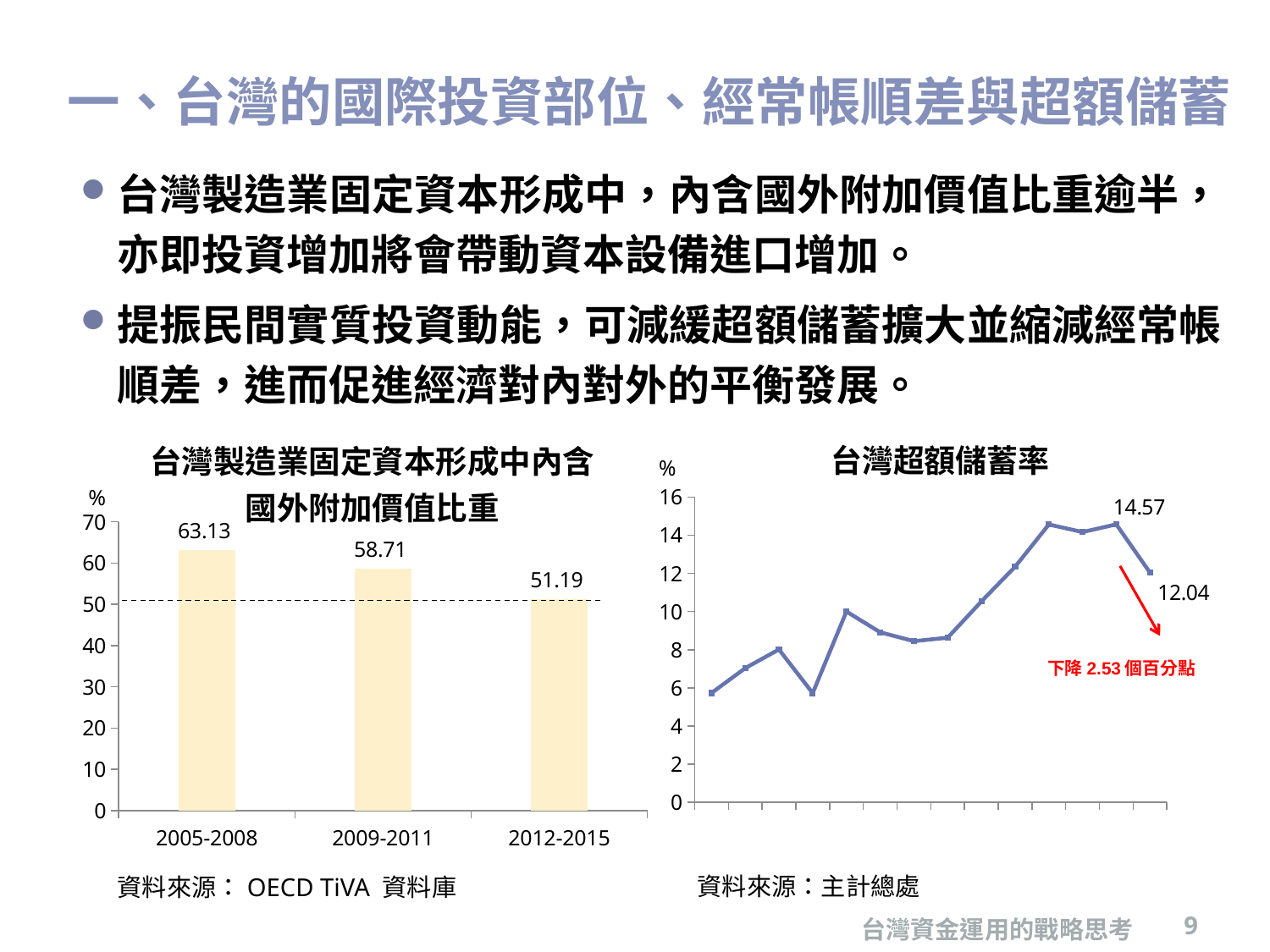
In the left chart (台灣製造業固定資本形成中內含國外附加價值比重), do the values rise or fall from 2005-2008 to 2012-2015? fall What kind of chart is the right chart (台灣超額儲蓄率)? line chart What kind of chart is the left chart (台灣製造業固定資本形成中內含國外附加價值比重)? bar chart In the right chart (台灣超額儲蓄率), what is the value of the last point on the line? 12.04 In the right chart (台灣超額儲蓄率), is the value of the first point on the line greater or less than 8? less In the left chart (台灣製造業固定資本形成中內含國外附加價值比重), what is the value for 2005-2008? 63.13 In the left chart (台灣製造業固定資本形成中內含國外附加價值比重), which period has the lowest value? 2012-2015 In the right chart (台灣超額儲蓄率), what is the difference between the labelled peak value 14.57 and the final value 12.04? 2.53 In the left chart (台灣製造業固定資本形成中內含國外附加價值比重), which period has the highest value? 2005-2008 In the left chart (台灣製造業固定資本形成中內含國外附加價值比重), what is the difference between the 2005-2008 value and the 2009-2011 value? 4.42 In the left chart (台灣製造業固定資本形成中內含國外附加價值比重), what is the value for 2012-2015? 51.19 In the left chart (台灣製造業固定資本形成中內含國外附加價值比重), how many periods are shown? 3